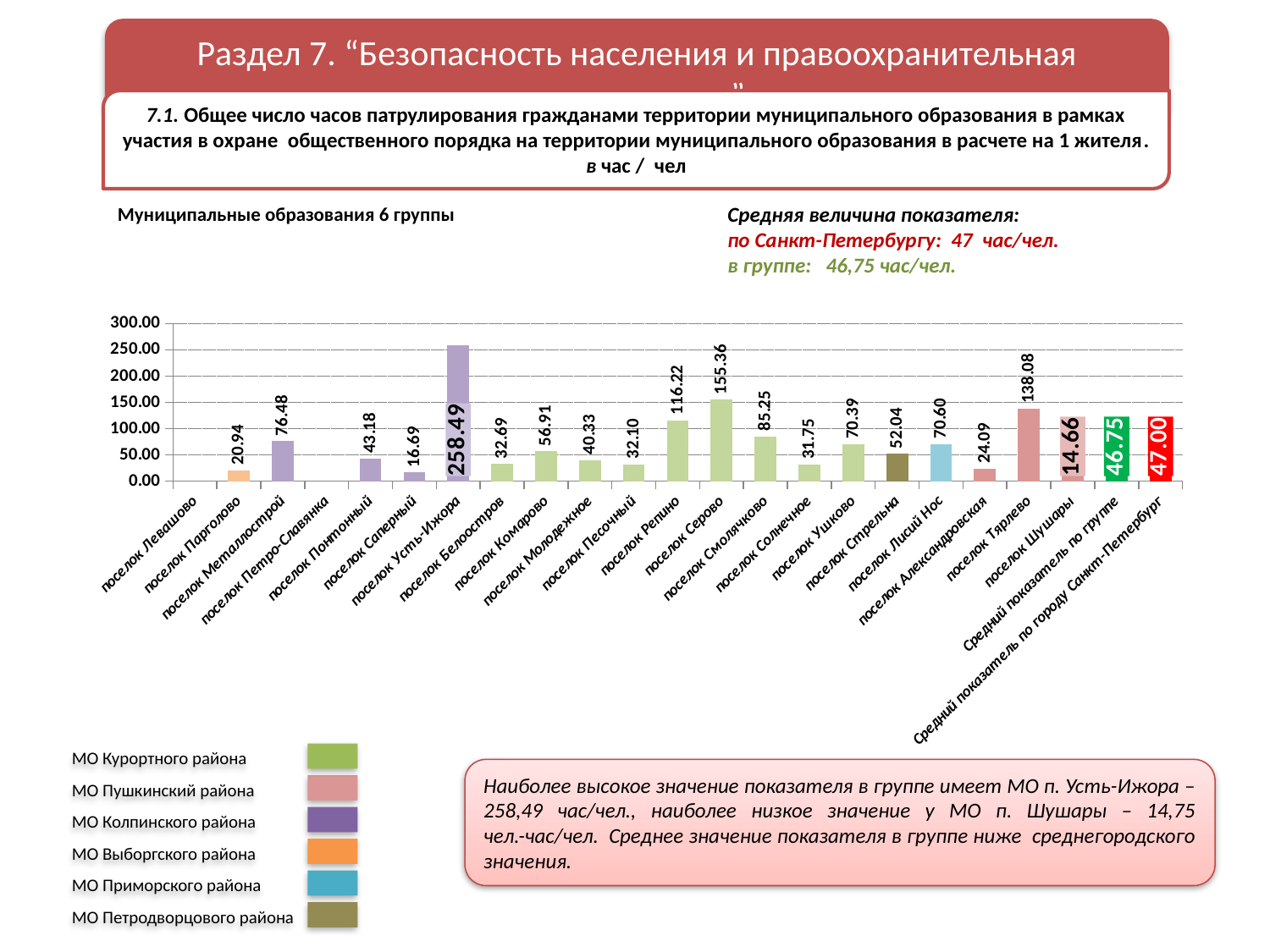
Is the value for поселок Репино greater or less than 100.00? greater What is the difference between the values for поселок Серово and поселок Репино? 39.14 Which is larger, the value for поселок Металлострой or for поселок Лисий Нос? поселок Металлострой What is the value for поселок Стрельна? 52.04 What is the value for поселок Тярлево? 138.08 What is the value shown for Средний показатель по группе? 46.75 Among the bars with data labels, which settlement has the lowest value? поселок Шушары What type of chart is shown on the slide? bar chart How many entries does the legend below the chart list? 6 Which settlement has the highest value in the chart? поселок Усть-Ижора What is the value for поселок Усть-Ижора? 258.49 What is the difference between the values for поселок Усть-Ижора and поселок Тярлево? 120.41